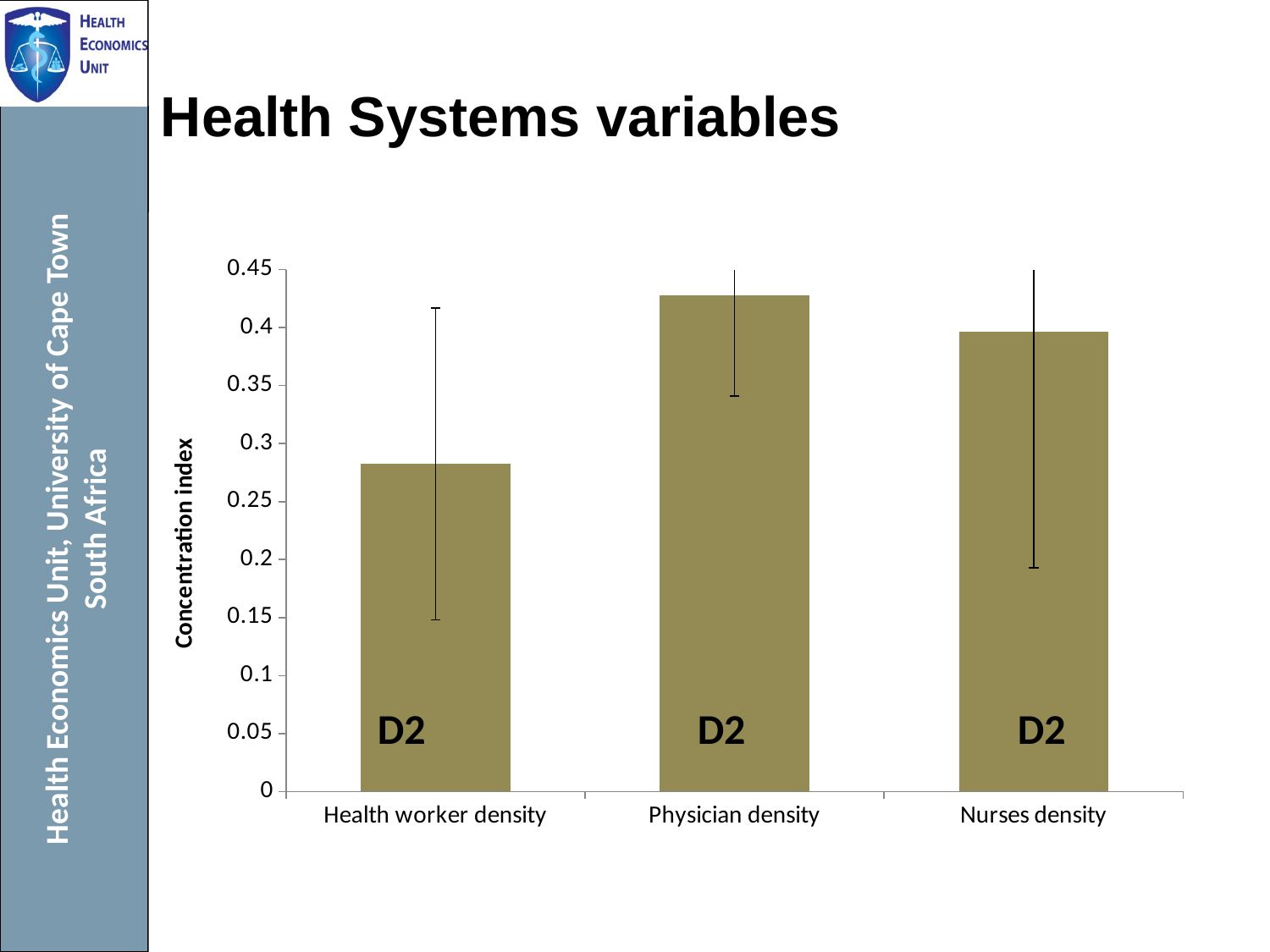
Which category has the highest concentration index? Physician density Is the value for Health worker density greater or less than 0.25? greater What kind of chart is shown on the slide? bar chart Is the value for Health worker density greater or less than 0.35? less Which has a larger concentration index, Health worker density or Physician density? Physician density Is the value for Nurses density greater or less than 0.35? greater What label is printed inside each bar? D2 What is the title of the vertical axis? Concentration index How many categories are plotted on the chart? 3 Which category has the lowest concentration index? Health worker density Which has a larger concentration index, Health worker density or Nurses density? Nurses density